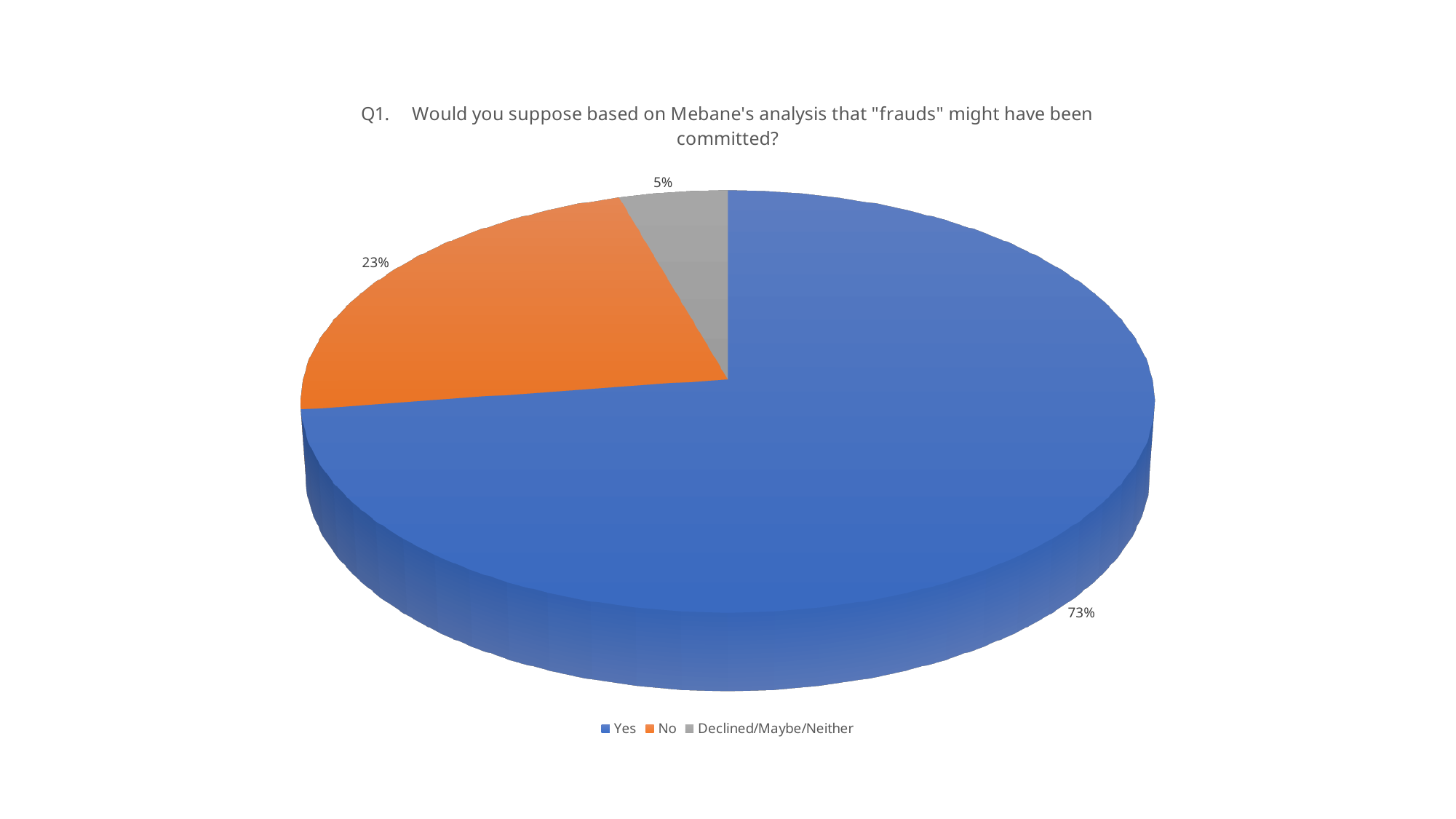
Which category has the largest slice? Yes How many slices does the pie chart have? 3 What is the difference in percentage points between the "No" and "Declined/Maybe/Neither" slices? 18 Which category has the smallest slice? Declined/Maybe/Neither What share of the pie does "No" take? 23% What share of the pie does "Yes" take? 73% What colour is the "Yes" slice? blue What is the difference in percentage points between the "Yes" and "No" slices? 50 Which is larger, the "No" slice or the "Declined/Maybe/Neither" slice? No What share of the pie does "Declined/Maybe/Neither" take? 5% What is the title of the chart? Q1. Would you suppose based on Mebane's analysis that "frauds" might have been committed? What kind of chart is shown on the slide? pie chart